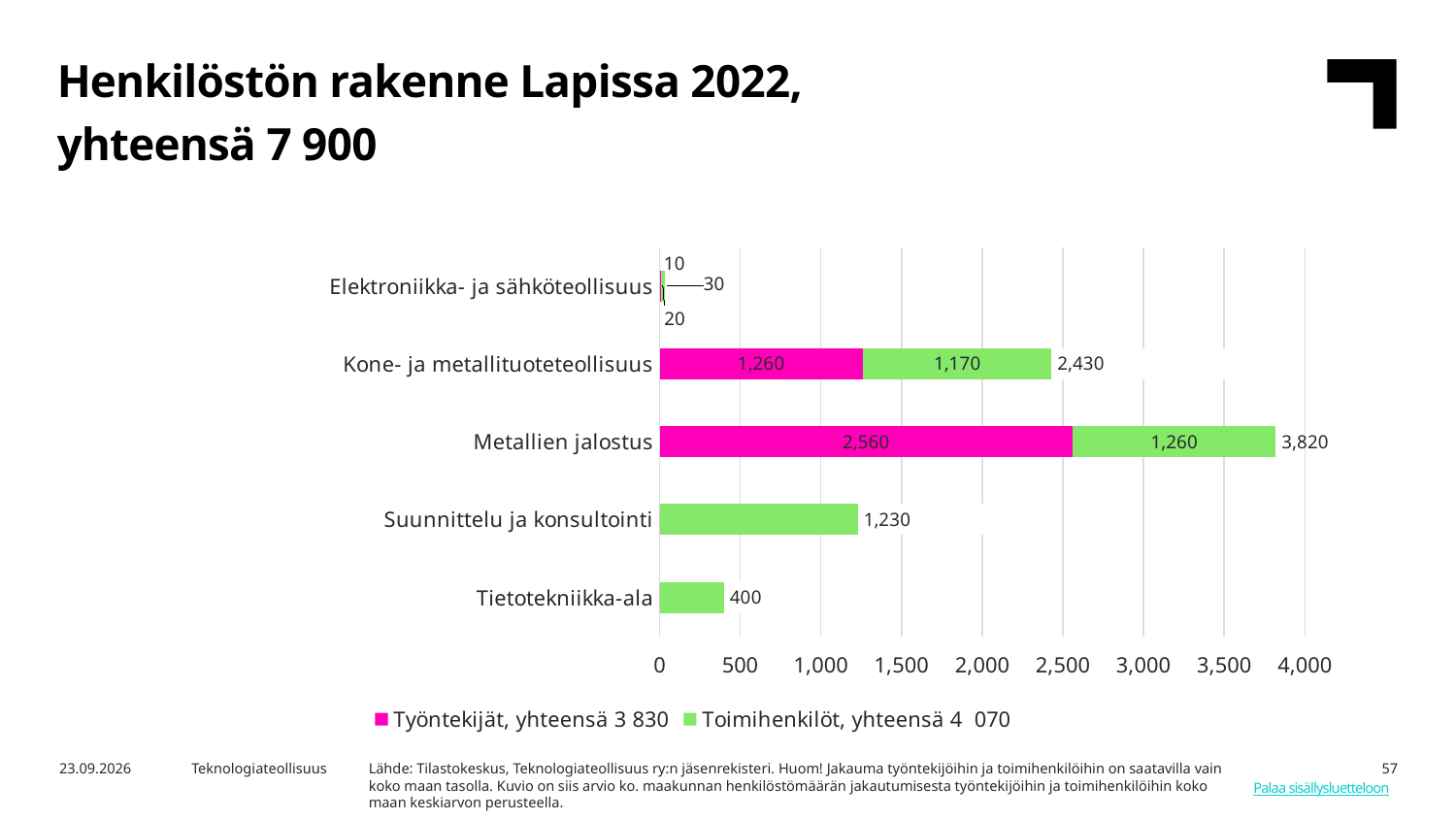
What is the total of the stacked bar for Metallien jalostus? 3,820 Which category has the highest total value? Metallien jalostus What is the value shown for Tietotekniikka-ala? 400 What kind of chart is shown on the slide? stacked bar chart What is the total of the stacked bar for Kone- ja metallituoteteollisuus? 2,430 What is the Toimihenkilöt value for Kone- ja metallituoteteollisuus? 1,170 Which category has the lowest total value? Elektroniikka- ja sähköteollisuus Which is larger: the value for Suunnittelu ja konsultointi or the value for Tietotekniikka-ala? Suunnittelu ja konsultointi How many categories are shown on the chart? 5 How many series does the legend list? 2 What is the difference between the Työntekijät values for Metallien jalostus and Kone- ja metallituoteteollisuus? 1,300 What is the Työntekijät value for Metallien jalostus? 2,560